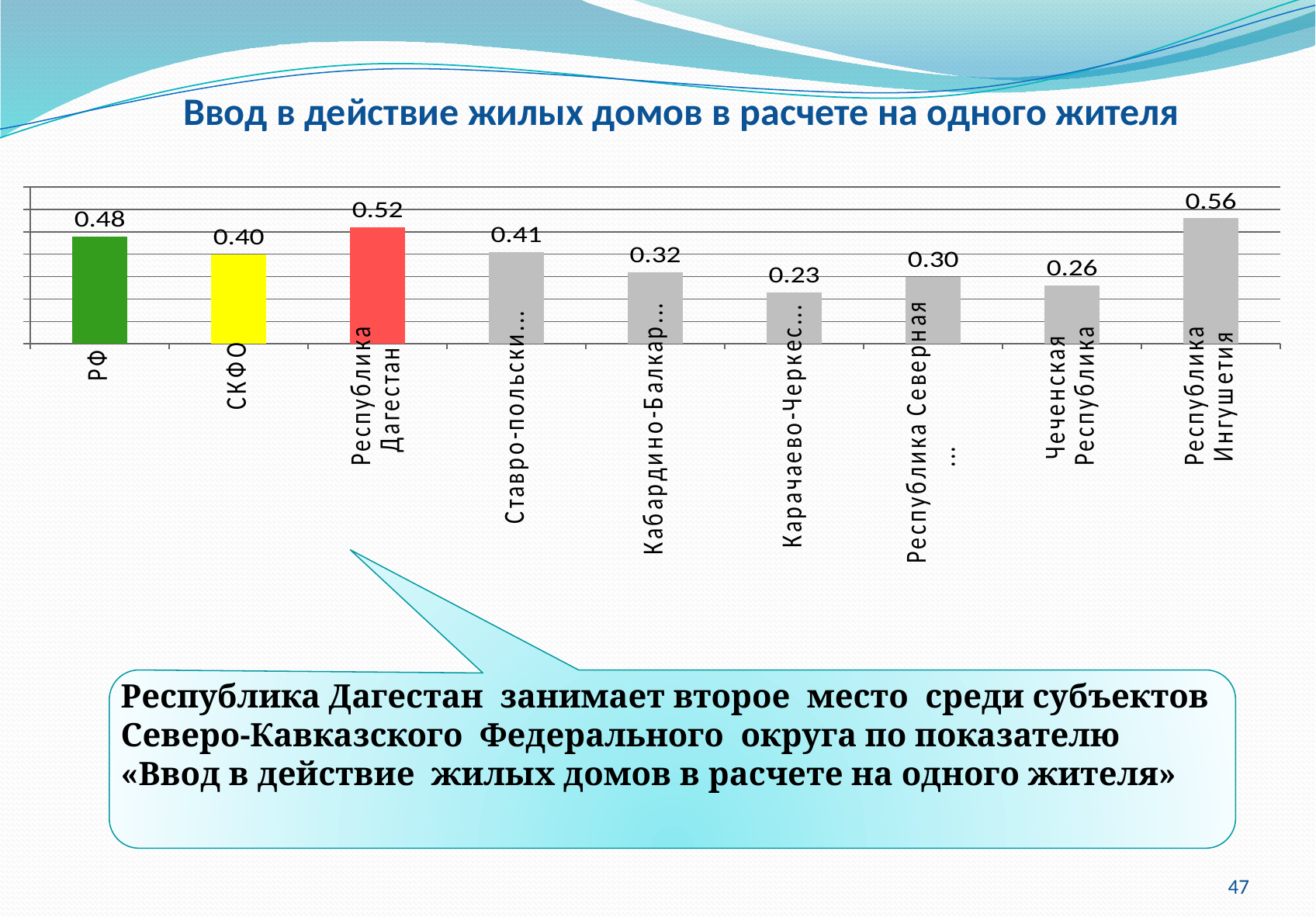
What is the value for Республика Ингушетия? 0.56 What kind of chart is shown on the slide? bar chart What is the value for СКФО? 0.40 What is the value for Чеченская Республика? 0.26 What colour is the bar for Республика Дагестан? red What is the difference between the values for Республика Ингушетия and Республика Дагестан? 0.04 How many bars are shown in the chart? 9 What is the value for Республика Дагестан? 0.52 Which category has the highest value? Республика Ингушетия What is the value for РФ? 0.48 Which category has the lowest value? Карачаево-Черкес... Which is larger, the value for Республика Дагестан or the value for РФ? Республика Дагестан